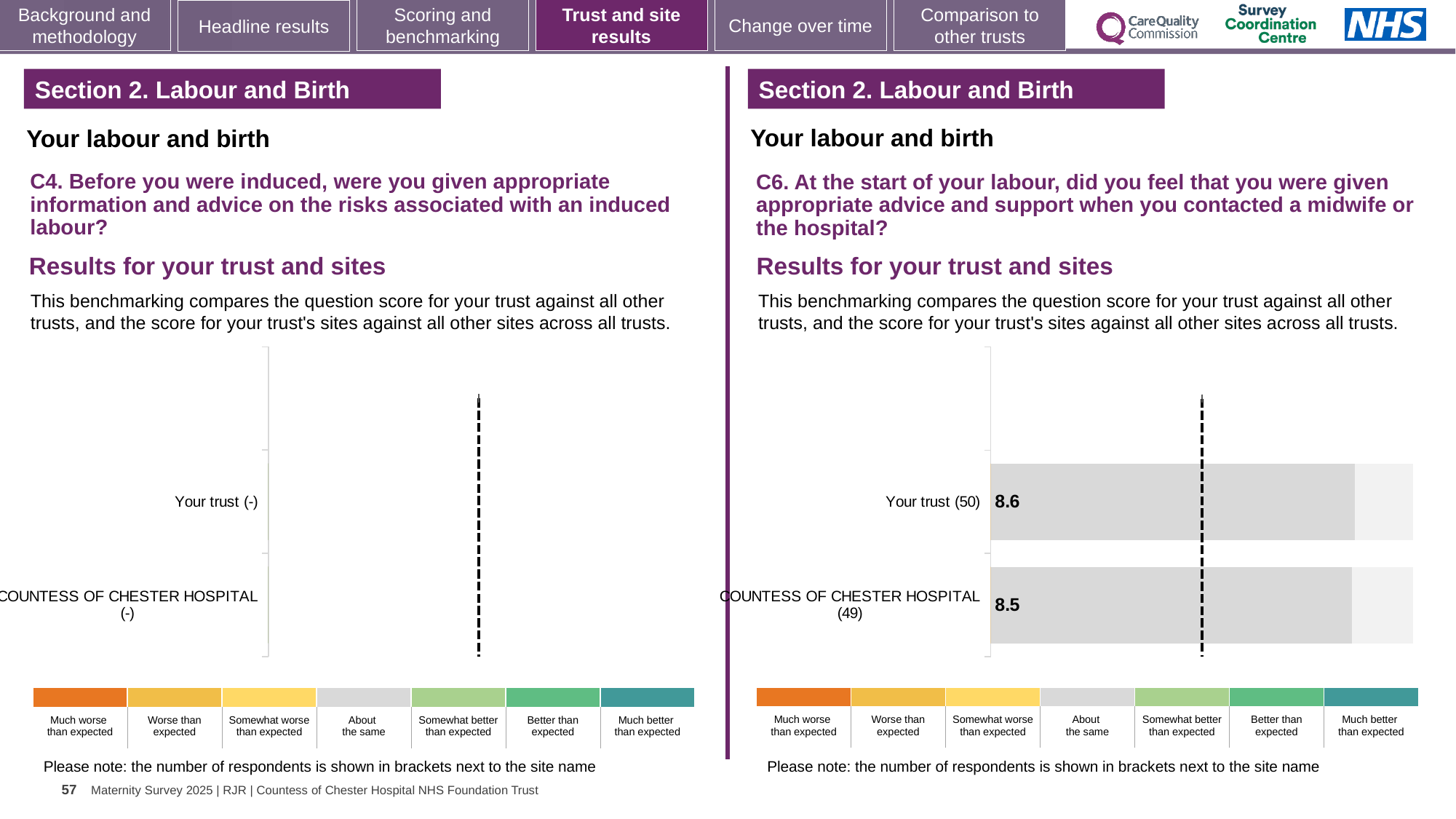
On the right chart (C6), what is the score for Your trust? 8.6 On the right chart (C6), how many respondents are shown in brackets for Your trust? 50 On the right chart (C6), which category has the lower score? Countess of Chester Hospital On the right chart (C6), how many categories are plotted? 2 On the right chart (C6), what is the difference between the score for Your trust and the score for Countess of Chester Hospital? 0.1 On the right chart (C6), which category has the higher score? Your trust How many categories does the colour key below the right chart (C6) list? 7 On the right chart (C6), is the score for Your trust larger or smaller than the score for Countess of Chester Hospital? larger On the right chart (C6), how many respondents are shown in brackets for Countess of Chester Hospital? 49 What kind of chart is shown on the right side of the slide (C6)? bar chart On the left chart (C4), what is shown in brackets next to Your trust? - On the right chart (C6), what is the score for Countess of Chester Hospital? 8.5